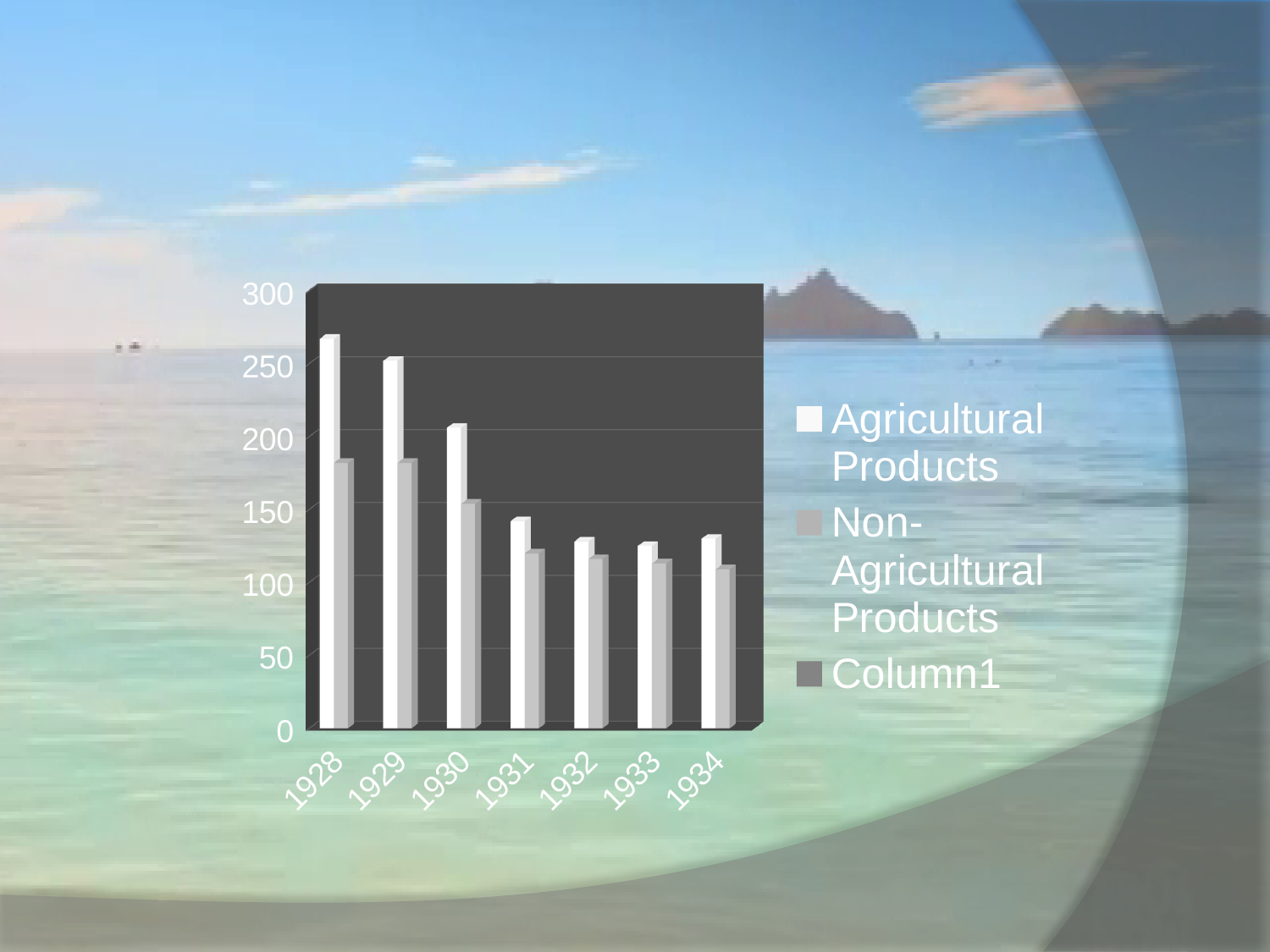
In 1928, which is larger: Agricultural Products or Non-Agricultural Products? Agricultural Products What is the third entry listed in the chart's legend? Column1 Is the Non-Agricultural Products value for 1928 greater or less than 150? greater What kind of chart is shown on the slide? bar chart Is the Agricultural Products value for 1928 greater or less than 250? greater How many years are shown along the x axis of the chart? 7 In which year is the Agricultural Products value highest? 1928 Is the Agricultural Products value for 1931 greater or less than 150? less Does the Agricultural Products series rise or fall from 1928 to 1931? fall What is the first year shown on the x axis? 1928 How many series does the chart's legend list? 3